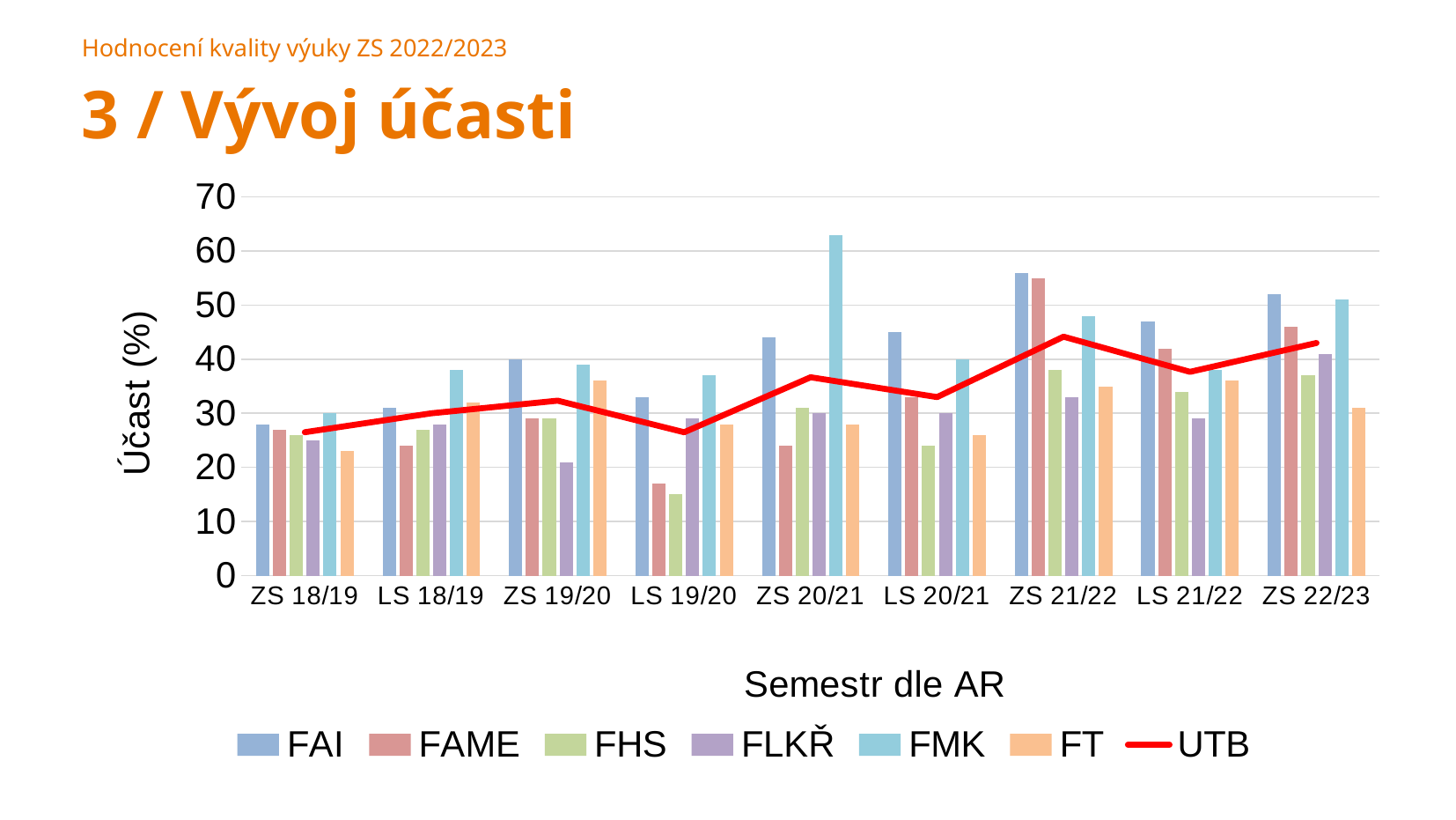
Does the UTB line rise or fall overall from ZS 18/19 to ZS 22/23? rises What kind of chart is shown on the slide? bar chart combined with a line Is the value for FMK in ZS 20/21 greater or less than 60? greater How many semesters are shown on the x axis of the chart? 9 What is the label of the vertical axis of the chart? Účast (%) How many series does the chart legend list? 7 Is the value for FLKŘ in ZS 19/20 greater or less than 30? less Is the value for FHS in LS 19/20 greater or less than 20? less In ZS 20/21, which is larger, the value for FMK or the value for FAME? FMK Which series has the lowest bar in LS 19/20? FHS Which series has the highest bar in ZS 20/21? FMK